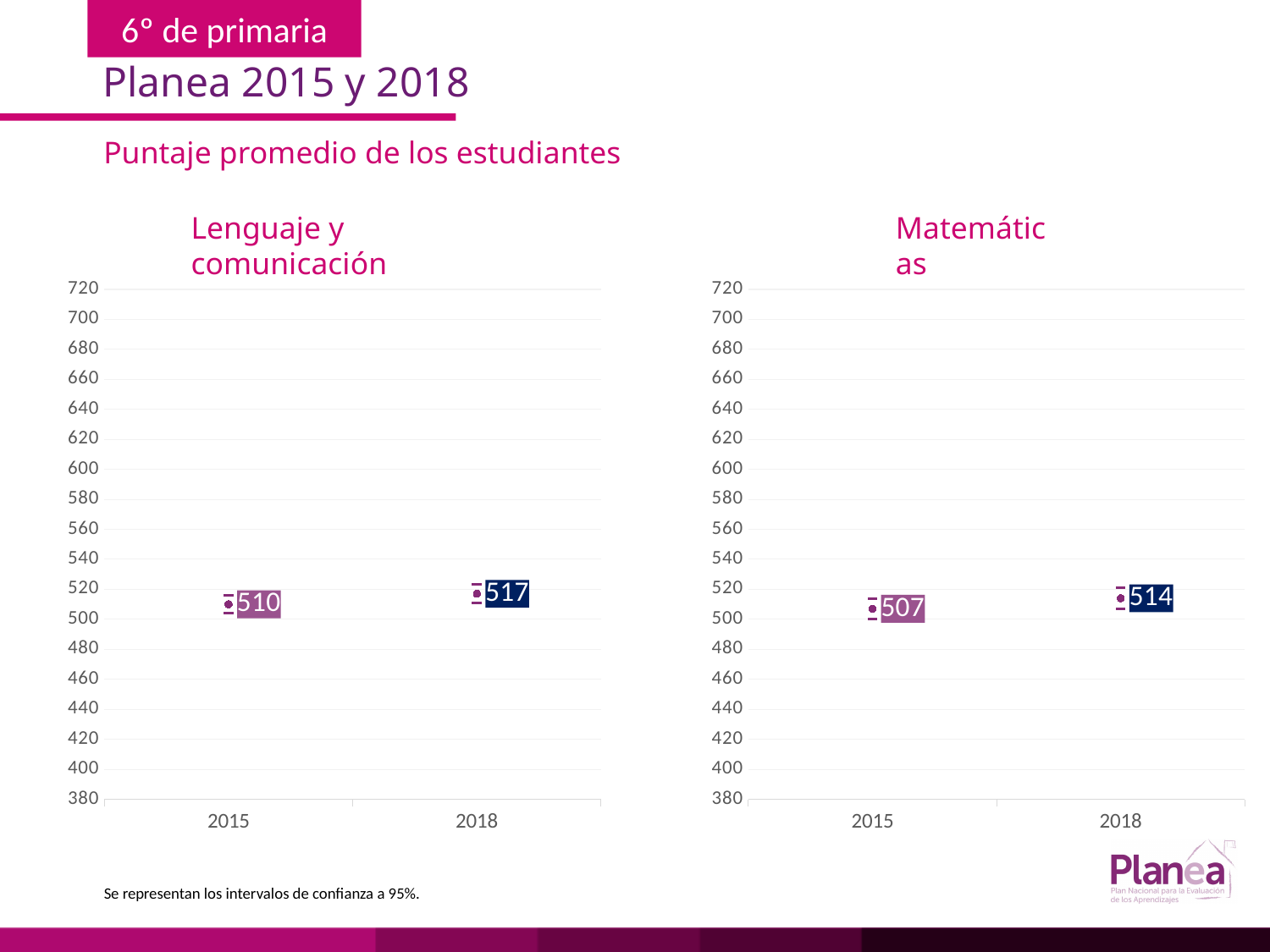
What is the lowest value shown on the vertical axis of the 'Lenguaje y comunicación' chart? 380 Do the values in the 'Matemáticas' chart rise or fall from 2015 to 2018? rise How many years are plotted in the 'Lenguaje y comunicación' chart? 2 In the 'Lenguaje y comunicación' chart, what is the value for 2015? 510 In the 'Lenguaje y comunicación' chart, what is the value for 2018? 517 In the 'Matemáticas' chart, is the value for 2015 greater or less than 500? greater In the 'Matemáticas' chart, what is the value for 2018? 514 In the 'Matemáticas' chart, which year has the lower value? 2015 In the 'Lenguaje y comunicación' chart, what is the difference between the 2018 and 2015 values? 7 In the 'Matemáticas' chart, what is the difference between the 2018 and 2015 values? 7 In the 'Matemáticas' chart, what is the value for 2015? 507 In the 'Lenguaje y comunicación' chart, which year has the higher value? 2018